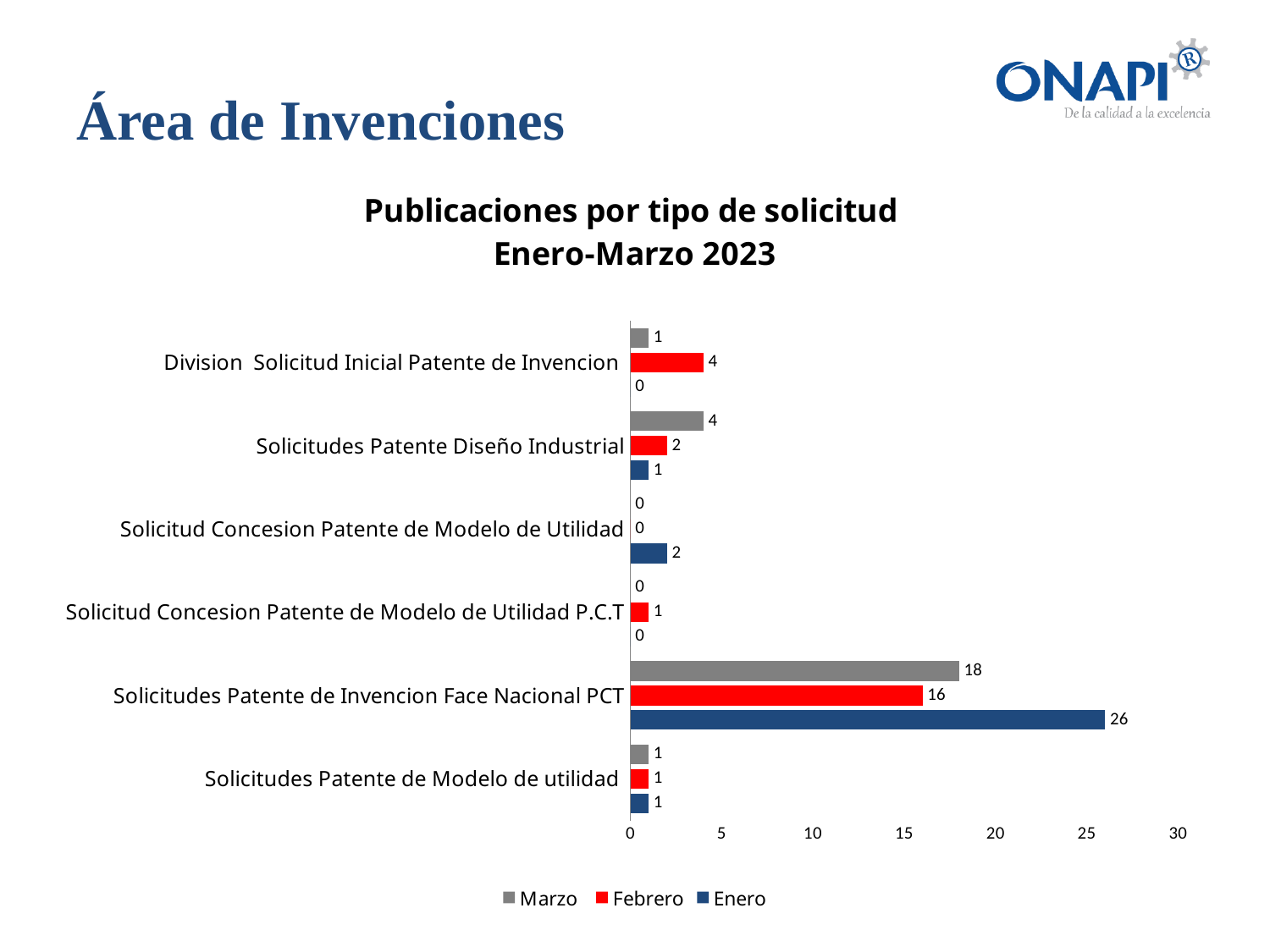
What is the Enero value for Solicitud Concesion Patente de Modelo de Utilidad? 2 What is the Febrero value for Division Solicitud Inicial Patente de Invencion? 4 What is the Enero value for Solicitudes Patente de Invencion Face Nacional PCT? 26 What kind of chart is shown on the slide? bar chart How many categories are shown on the chart? 6 How many series does the legend list? 3 What is the title of the chart? Publicaciones por tipo de solicitud Enero-Marzo 2023 For Solicitudes Patente Diseño Industrial, which is larger: the Marzo value or the Febrero value? Marzo What is the Marzo value for Solicitudes Patente de Invencion Face Nacional PCT? 18 Is the Enero value for Solicitudes Patente de Invencion Face Nacional PCT greater or less than 25? greater Which category has the highest Enero value? Solicitudes Patente de Invencion Face Nacional PCT What is the difference between the Enero and Febrero values for Solicitudes Patente de Invencion Face Nacional PCT? 10